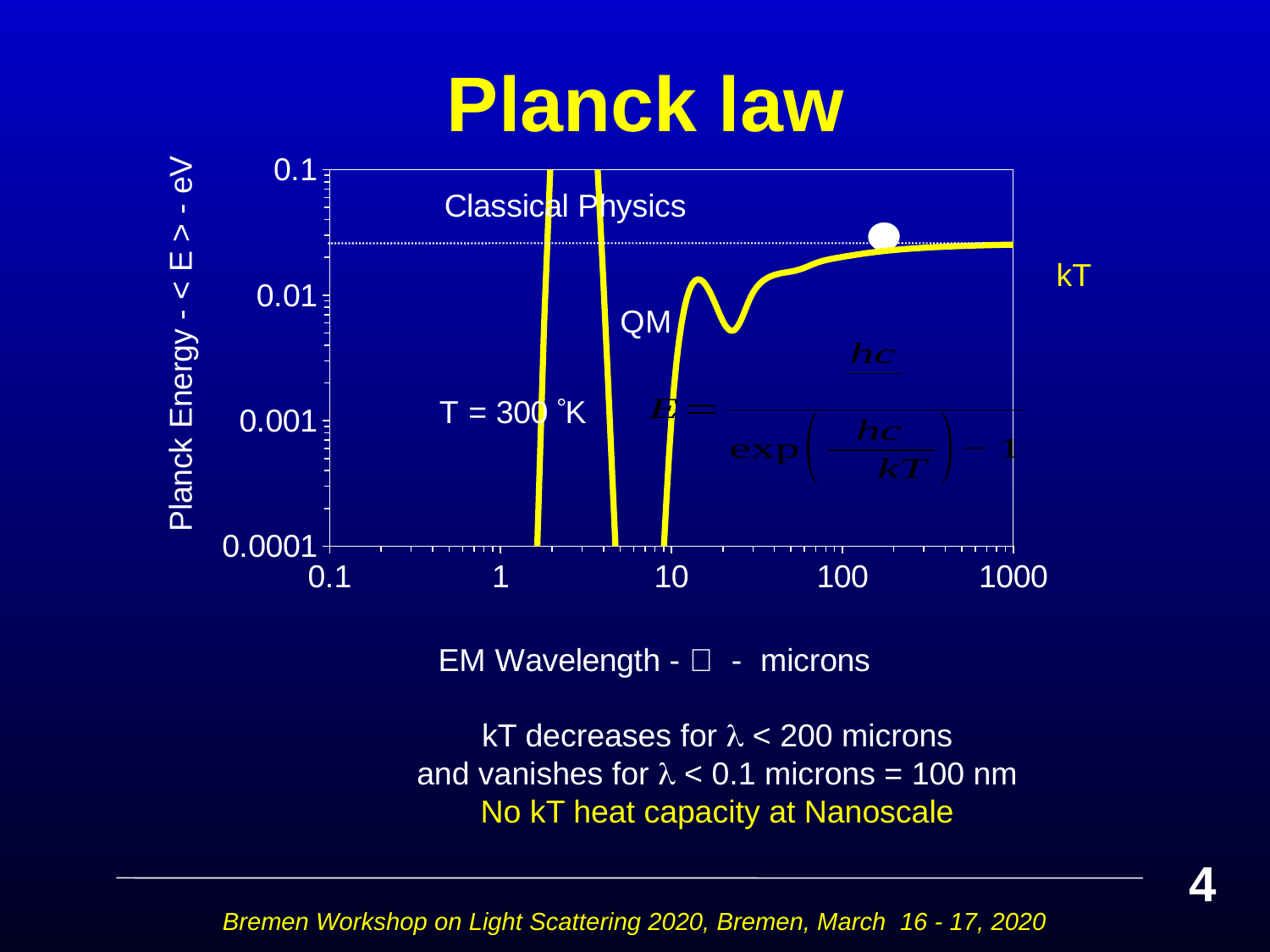
Is the Planck energy at a wavelength of 1000 microns greater or less than 0.1 eV? less What is the title of the chart on the slide? Planck law Does the Planck energy curve rise or fall as the wavelength increases from 10 microns to 1000 microns? rise How many labelled tick values are shown on the x axis of the chart? 5 How many labelled tick values are shown on the y axis of the chart? 4 What is the highest value labelled on the x axis of the chart? 1000 Is the Planck energy at a wavelength of 1000 microns greater or less than 0.01 eV? greater What temperature is annotated on the chart? T = 300 °K What is the lowest value labelled on the y axis of the chart? 0.0001 What kind of chart is shown on the slide? line chart Is the dotted kT level on the chart greater or less than 0.01 eV? greater